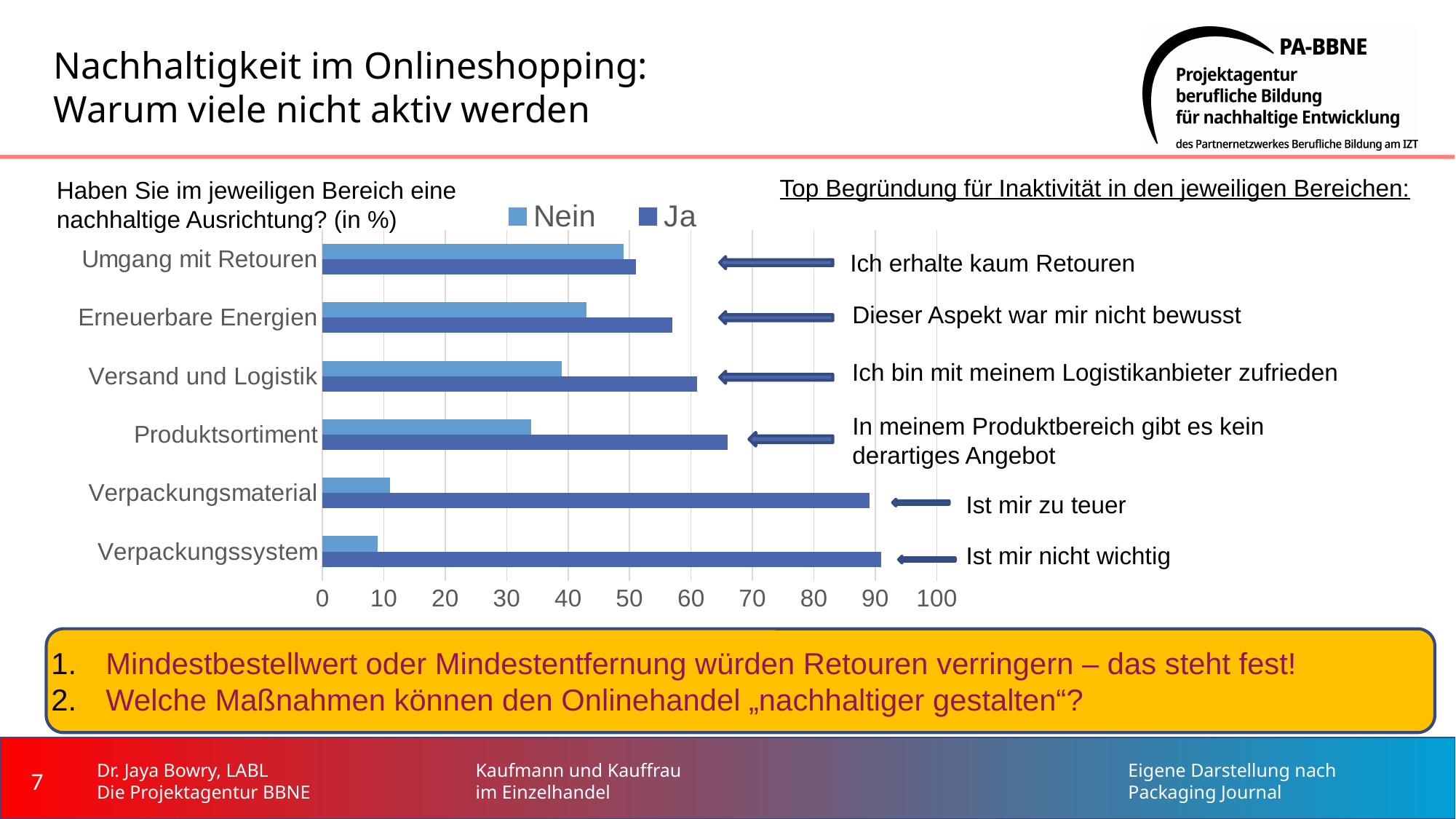
Which is larger: the Nein value for Verpackungsmaterial or the Nein value for Produktsortiment? Produktsortiment Do the Ja values rise or fall when reading the categories from Umgang mit Retouren down to Verpackungssystem? rise Is the Nein value for Verpackungssystem greater or less than 20? less Which category has the lowest value for the Ja series? Umgang mit Retouren Which category has the highest value for the Nein series? Umgang mit Retouren What are the two entries in the chart legend? Nein and Ja Is the Ja value for Verpackungsmaterial greater or less than 80? greater How many categories are shown on the chart? 6 Is the Ja value for Erneuerbare Energien greater or less than 50? greater How many series does the chart legend list? 2 What kind of chart is shown on the slide? bar chart